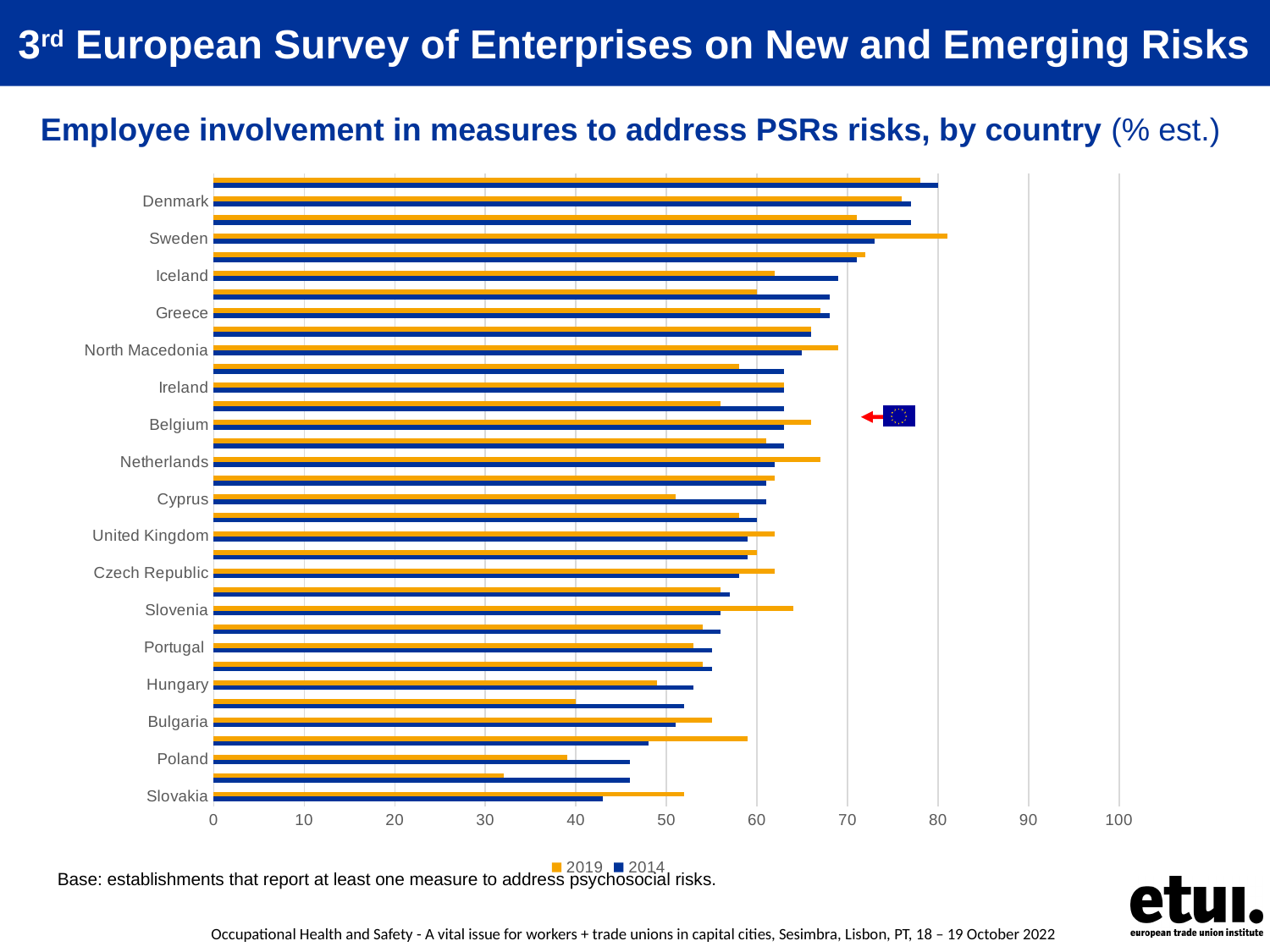
Is the 2014 value for Sweden greater or less than 80? less How many series does the legend list? 2 For Cyprus, which is larger: the 2019 value or the 2014 value? 2014 What kind of chart is shown on the slide? Bar chart Which colour represents the 2019 series? Orange Which two years are compared in the chart? 2019 and 2014 For Slovakia, which is larger: the 2019 value or the 2014 value? 2019 For Slovenia, which is larger: the 2019 value or the 2014 value? 2019 Is the 2019 value for Denmark greater or less than 70? greater Is the 2014 value for Iceland greater or less than 60? greater